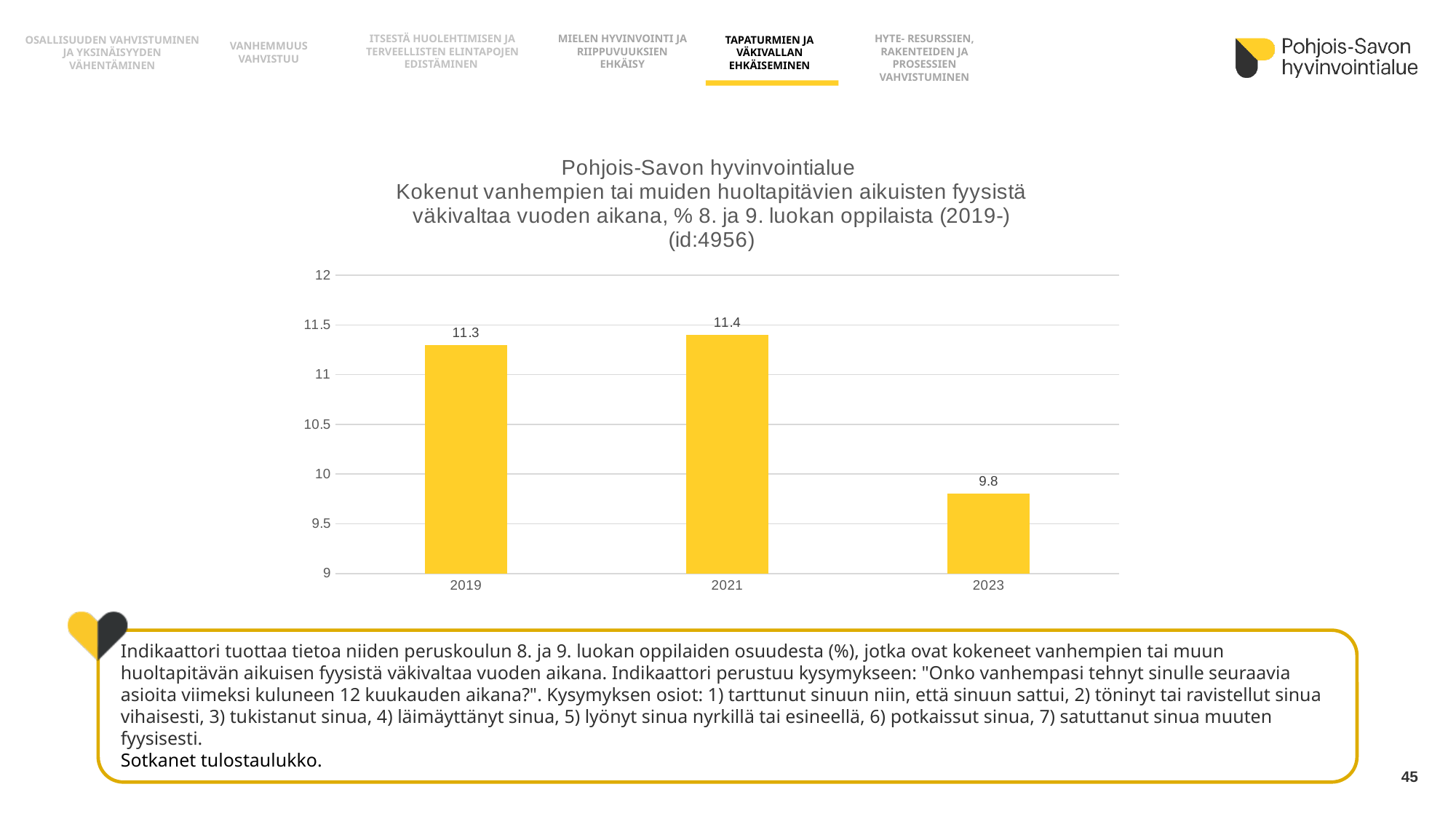
What is the indicator id shown in the chart title? id:4956 What is the value for 2021? 11.4 What is the difference between the values for 2021 and 2023? 1.6 What is the value for 2019? 11.3 What is the value for 2023? 9.8 Which is larger, the value for 2019 or the value for 2023? 2019 Which year has the lowest value? 2023 What kind of chart is shown on the slide? bar chart Is the value for 2023 greater or less than 10? less How many years are shown on the x axis? 3 Is the value for 2021 greater or less than 11? greater What is the difference between the values for 2019 and 2023? 1.5